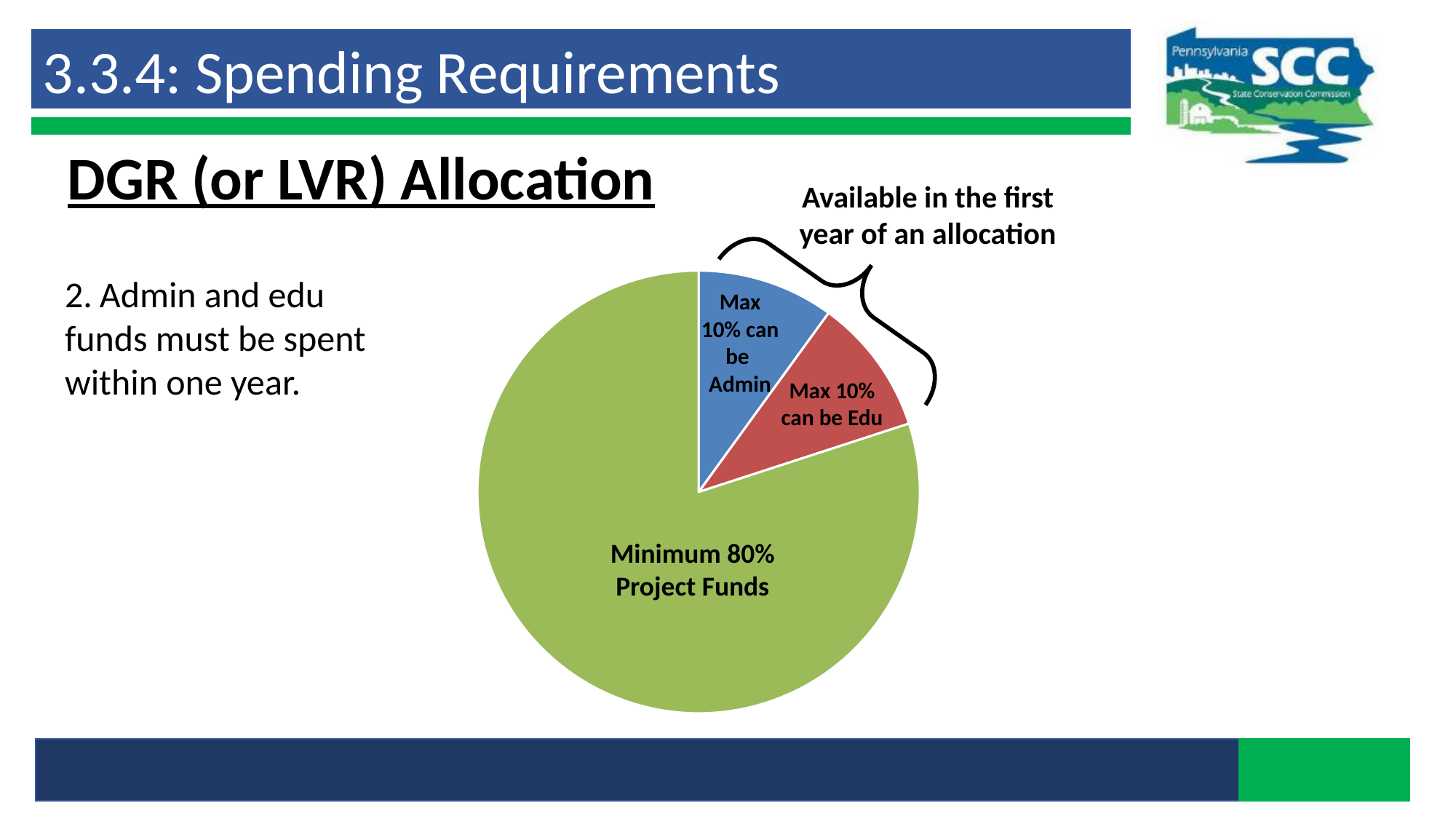
What is the difference between the Project Funds percentage and the Edu percentage shown on the pie chart? 70% How many slices does the pie chart have? 3 What share of the pie is labelled for Project Funds? Minimum 80% Which is larger in the pie chart, the Project Funds slice or the Admin slice? Project Funds What is the heading above the pie chart? DGR (or LVR) Allocation What colour is the Project Funds slice of the pie chart? green What share of the pie is labelled for Admin? Max 10% What colour is the Admin slice of the pie chart? blue Which slice of the pie chart is the largest? Minimum 80% Project Funds What kind of chart is shown on the slide? pie chart What share of the pie is labelled for Edu? Max 10%